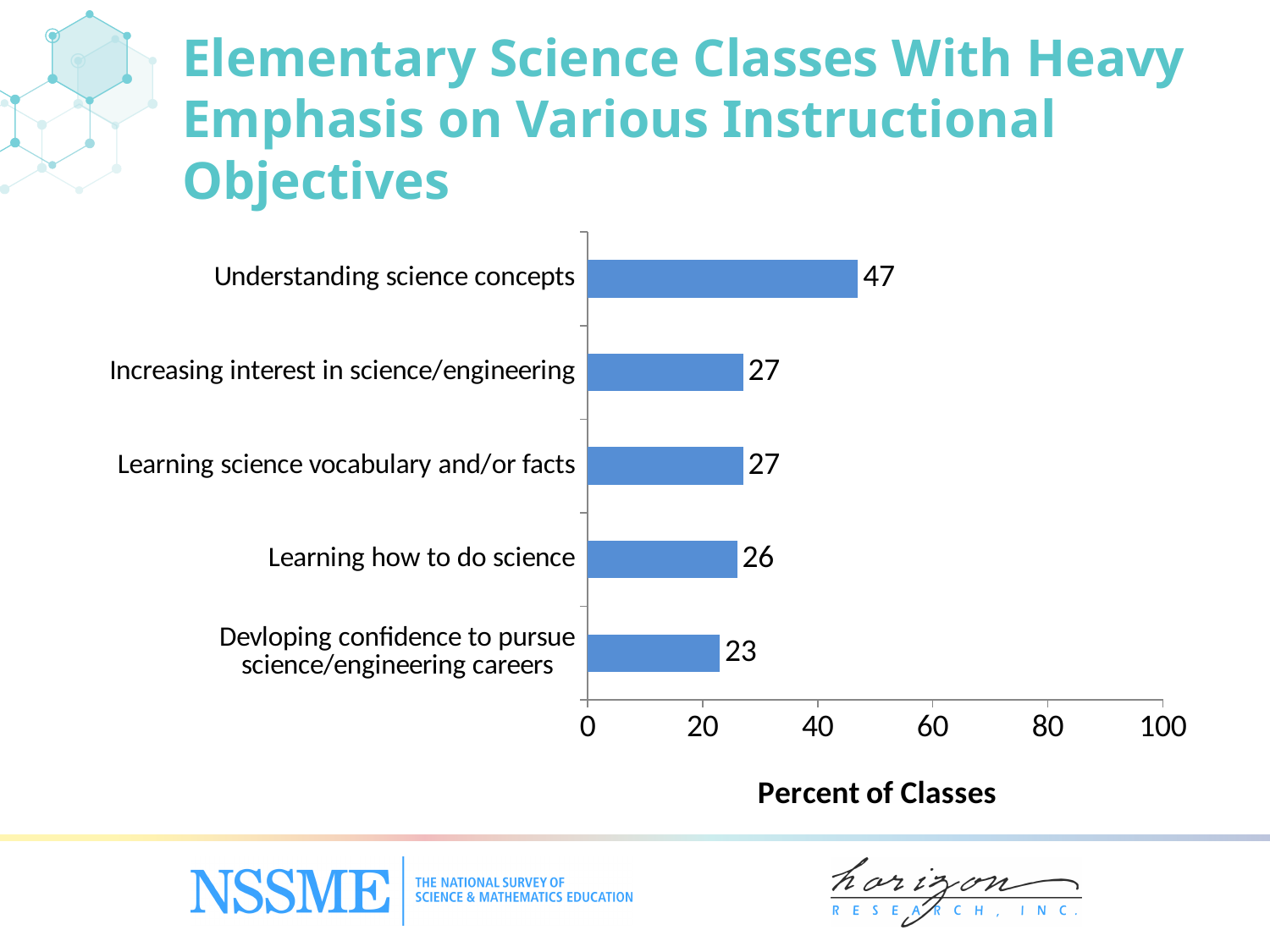
Which instructional objective has the highest percent of classes? Understanding science concepts What is the value for 'Increasing interest in science/engineering'? 27 What is the difference between the values for 'Learning how to do science' and 'Devloping confidence to pursue science/engineering careers'? 3 What is the value for 'Devloping confidence to pursue science/engineering careers'? 23 Which instructional objective has the lowest percent of classes? Devloping confidence to pursue science/engineering careers What is the difference between the values for 'Understanding science concepts' and 'Learning science vocabulary and/or facts'? 20 What percent of classes place heavy emphasis on understanding science concepts? 47 How many instructional objectives are shown in the chart? 5 What is the label of the horizontal axis? Percent of Classes Which is larger: the value for 'Understanding science concepts' or the value for 'Learning how to do science'? Understanding science concepts What kind of chart is shown on the slide? Bar chart What is the value for 'Learning how to do science'? 26